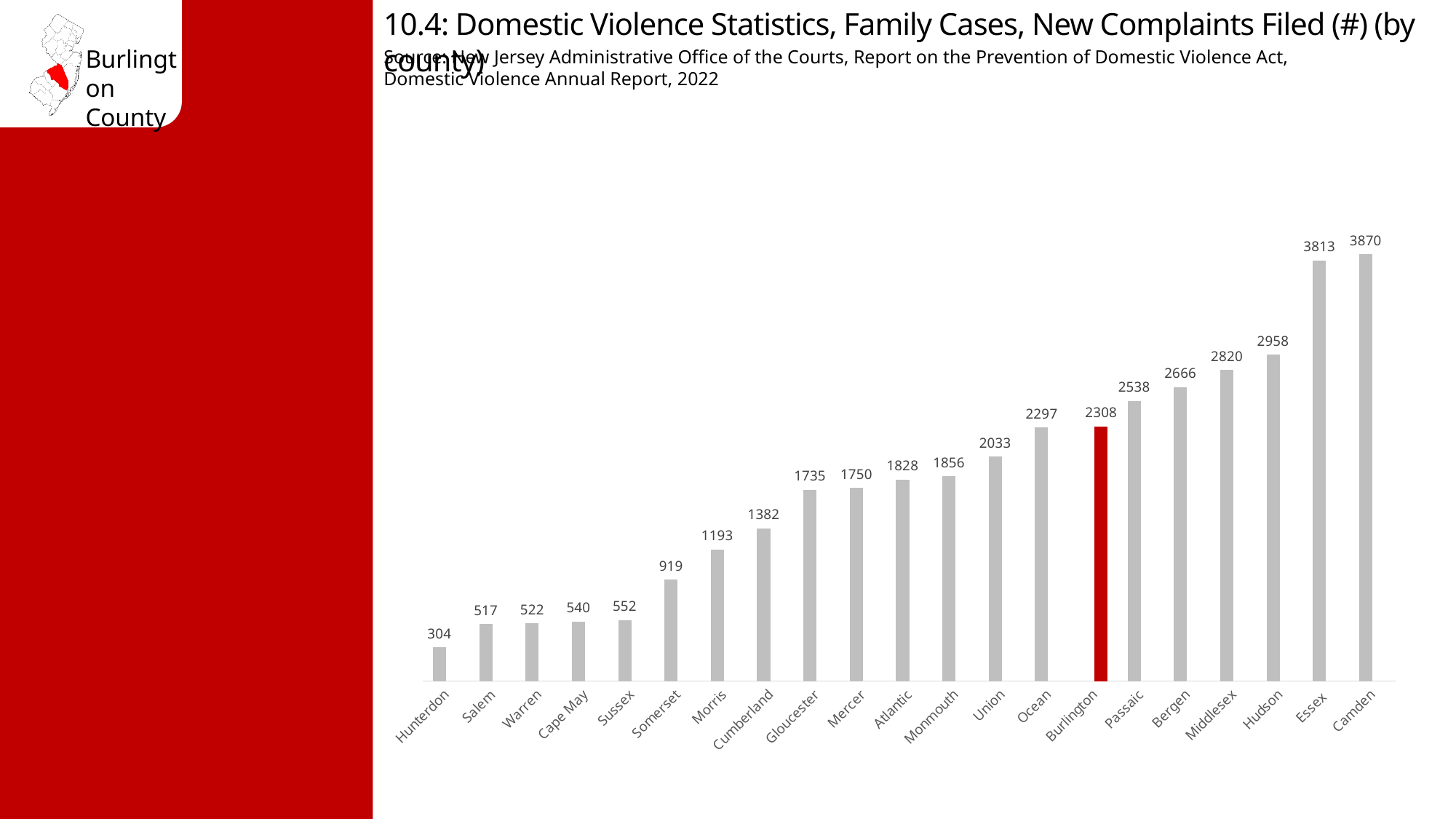
What is the difference between the values for Burlington and Hunterdon? 2004 Which county's bar is highlighted in red? Burlington Which is larger, the value for Passaic or the value for Union? Passaic What is the value for Camden? 3870 Which county has the lowest number of new complaints filed? Hunterdon Which county has the highest number of new complaints filed? Camden What is the value for Somerset? 919 What is the difference between the values for Camden and Essex? 57 What is the value for Burlington? 2308 How many counties are shown in the chart? 21 What kind of chart is shown on the slide? Bar chart Do the values rise or fall from left to right along the x axis? Rise